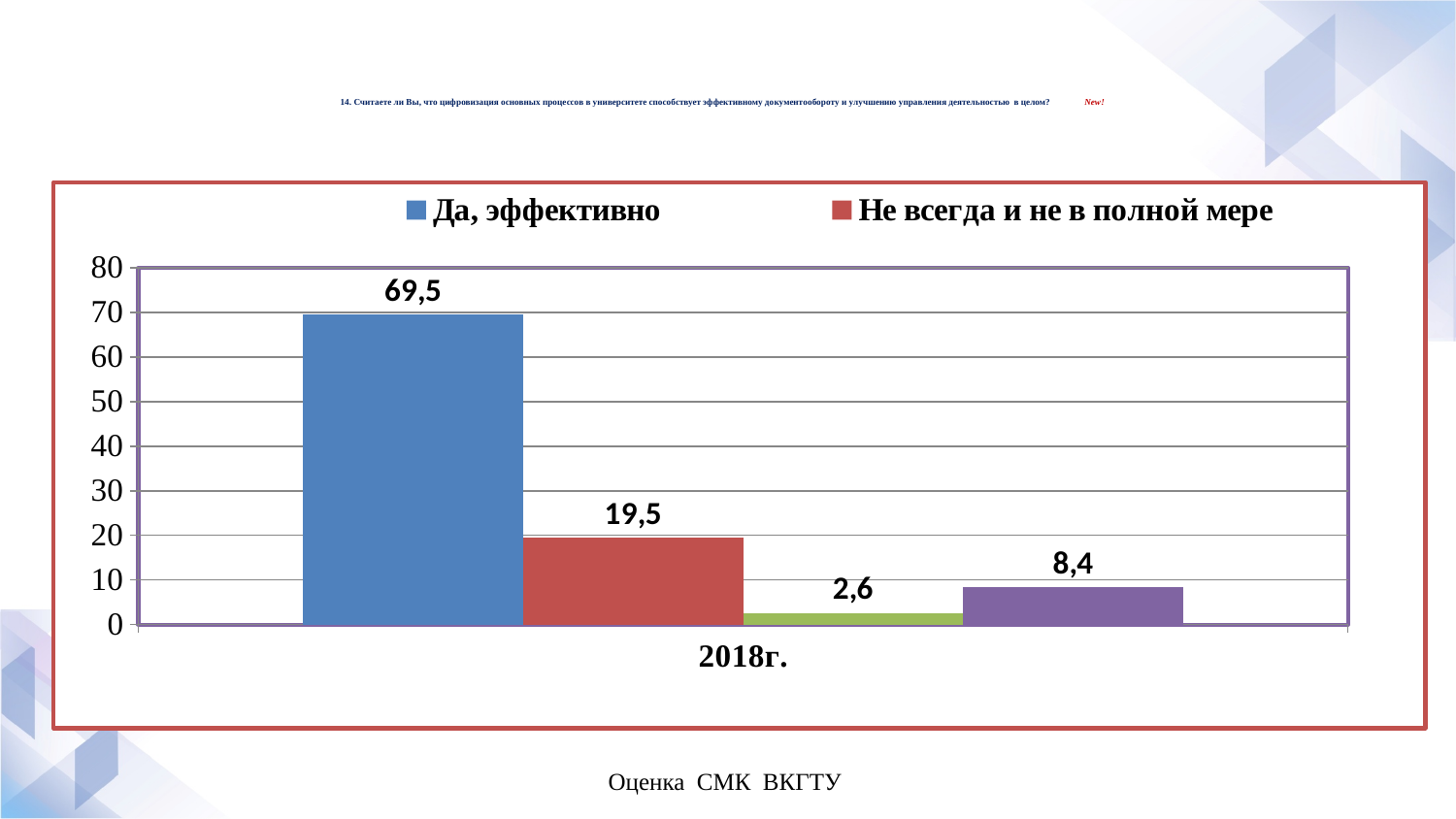
What value is printed on the purple bar? 8,4 What is the value for "Не всегда и не в полной мере"? 19,5 How many series does the legend list? 2 What is the difference between the values for "Да, эффективно" and "Не всегда и не в полной мере"? 50 What is the value for "Да, эффективно"? 69,5 What is the value of the lowest bar on the chart? 2,6 What value is printed on the green bar? 2,6 Which is larger, the purple bar or the green bar? the purple bar How many bars are plotted on the chart? 4 What kind of chart is shown on the slide? bar chart What is the difference between the purple bar and the green bar? 5,8 Which legend entry has the highest value? Да, эффективно